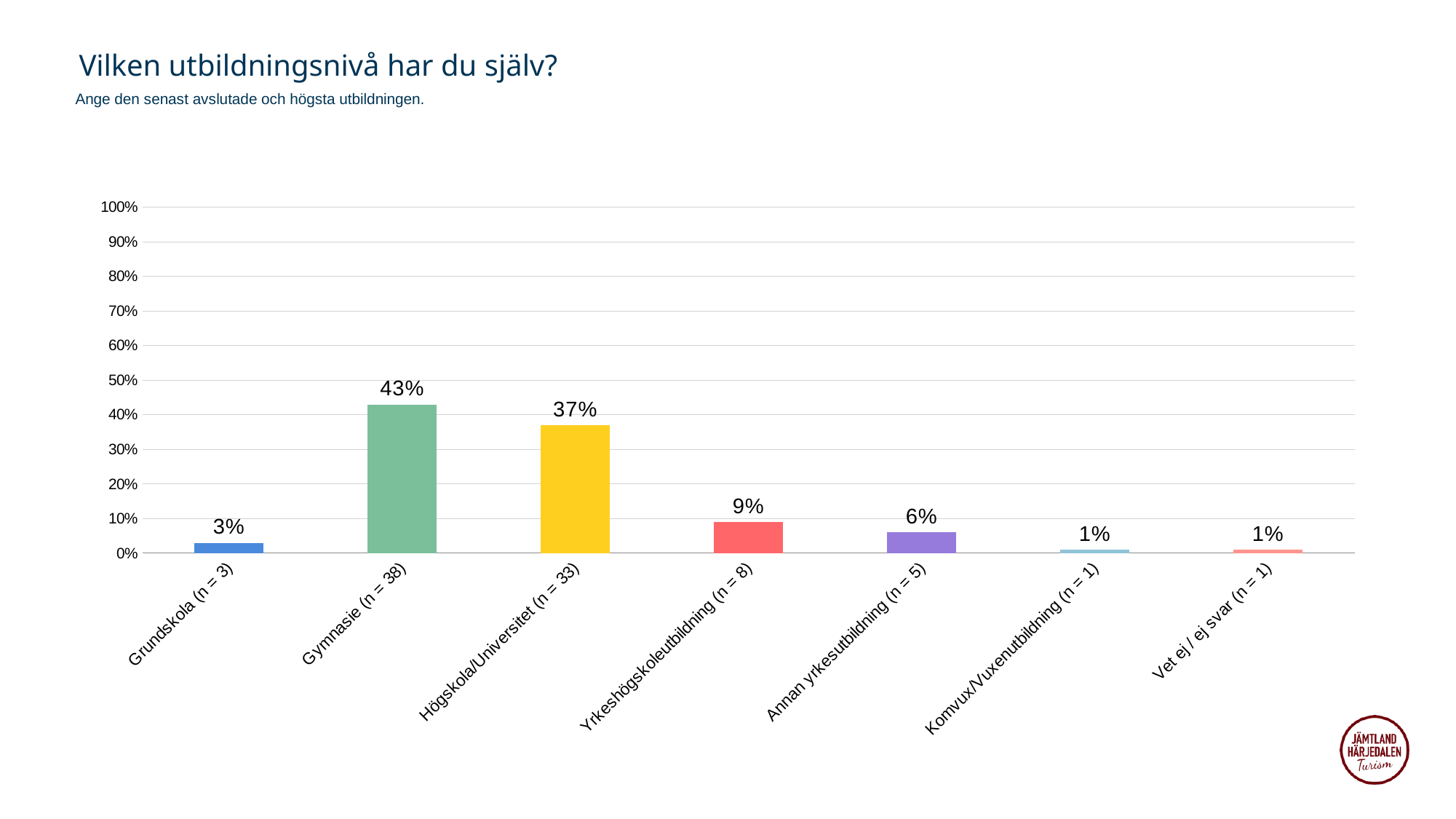
What is the value for Högskola/Universitet (n = 33)? 37% What is the title of the chart? Vilken utbildningsnivå har du själv? What is the value for Gymnasie (n = 38)? 43% What kind of chart is shown on the slide? bar chart What is the value for Yrkeshögskoleutbildning (n = 8)? 9% How many categories are shown on the x axis? 7 Which category has the highest value? Gymnasie (n = 38) What is the value for Annan yrkesutbildning (n = 5)? 6% What is the difference between the values for Gymnasie (n = 38) and Högskola/Universitet (n = 33)? 6% Is the value for Gymnasie (n = 38) greater or less than 40%? greater What is the value for Grundskola (n = 3)? 3% Which is larger, the value for Yrkeshögskoleutbildning (n = 8) or Annan yrkesutbildning (n = 5)? Yrkeshögskoleutbildning (n = 8)